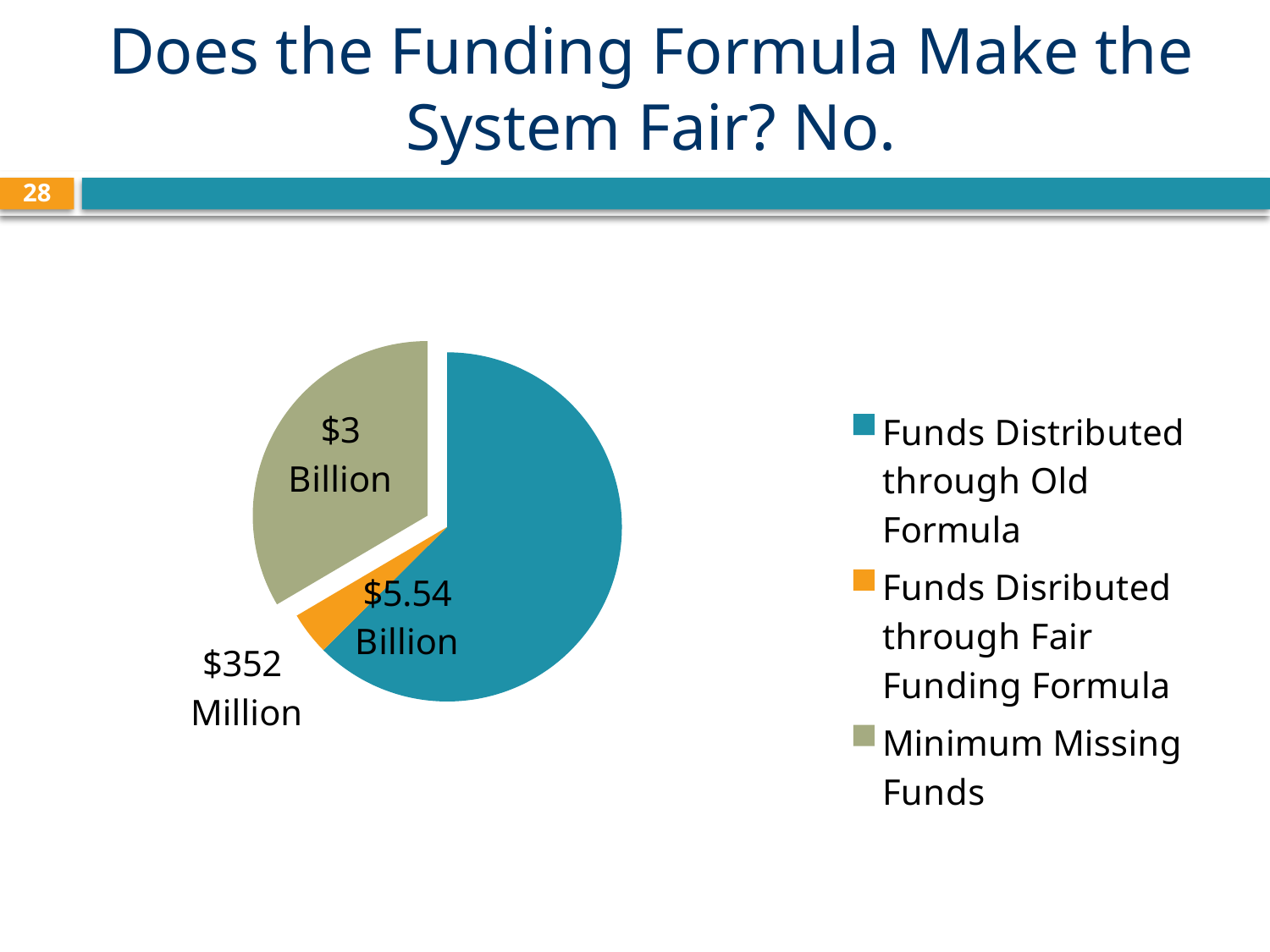
What is the value for Minimum Missing Funds? $3 Billion How many slices does the pie chart have? 3 What type of chart is shown on the slide? Pie chart What is the value for Funds Distributed through Old Formula? $5.54 Billion What is the value for Funds Disributed through Fair Funding Formula? $352 Million What colour is the slice for Funds Disributed through Fair Funding Formula? Orange What colour is the slice for Minimum Missing Funds? Green Which category has the smallest slice of the pie? Funds Disributed through Fair Funding Formula Which is larger: Minimum Missing Funds or Funds Disributed through Fair Funding Formula? Minimum Missing Funds Which category has the largest slice of the pie? Funds Distributed through Old Formula What is the difference between Funds Distributed through Old Formula and Minimum Missing Funds? $2.57 Billion How many entries does the legend list? 3